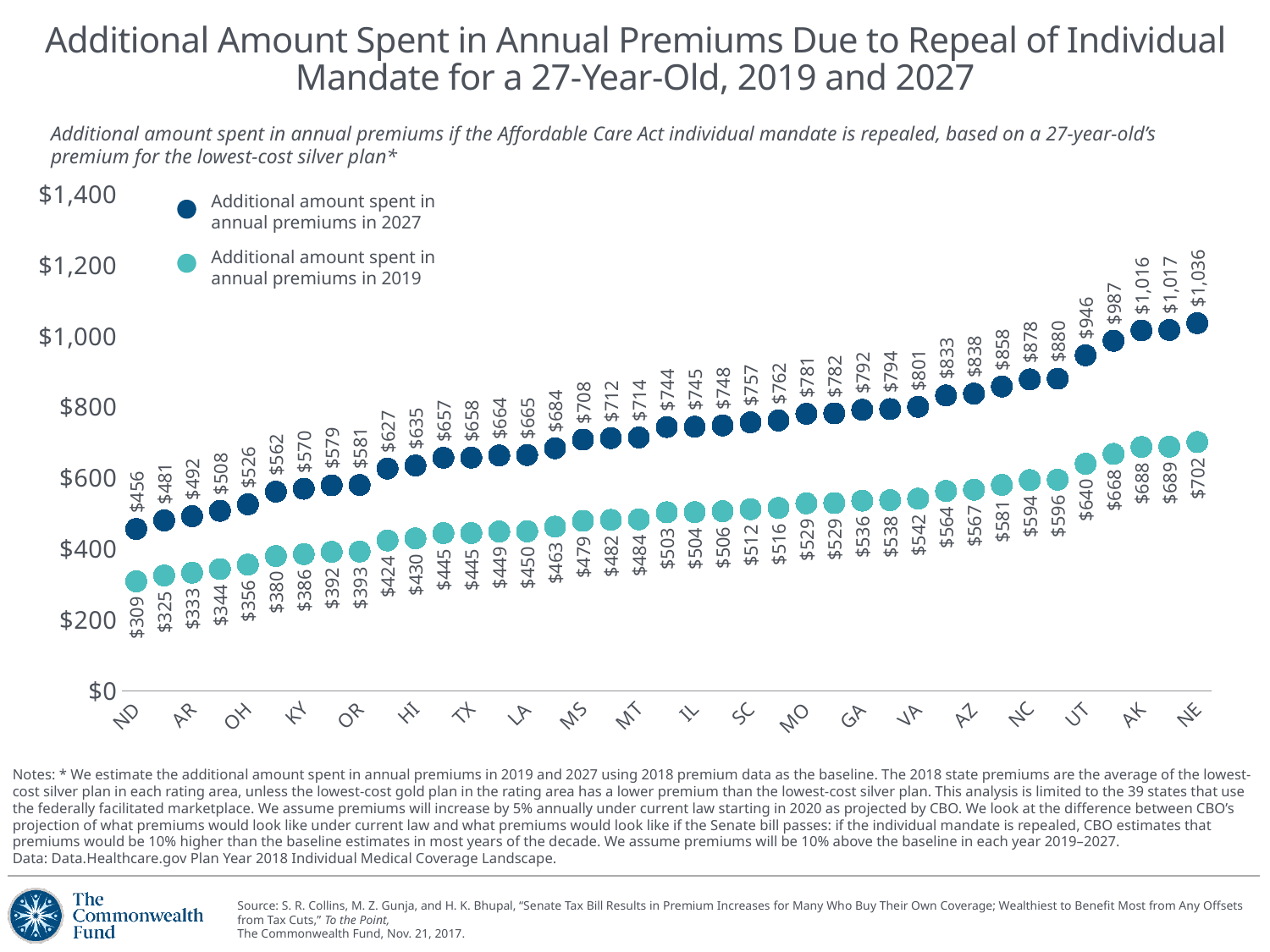
What is the additional amount spent in annual premiums in 2027 for ND? $456 What is the additional amount spent in annual premiums in 2027 for NE? $1,036 What is the additional amount spent in annual premiums in 2019 for ND? $309 Do the 2027 values rise or fall moving from ND on the left to NE on the right? rise Which state has the lowest additional amount spent in annual premiums in 2019? ND What type of chart is shown on the slide? Scatter/dot chart Which state has the highest additional amount spent in annual premiums in 2027? NE What is the additional amount spent in annual premiums in 2019 for NE? $702 How many series does the legend list? 2 Which series is shown with dark blue dots? Additional amount spent in annual premiums in 2027 Is the 2027 value for ND greater or less than $400? greater What is the difference between the 2027 and 2019 additional amounts for NE? $334